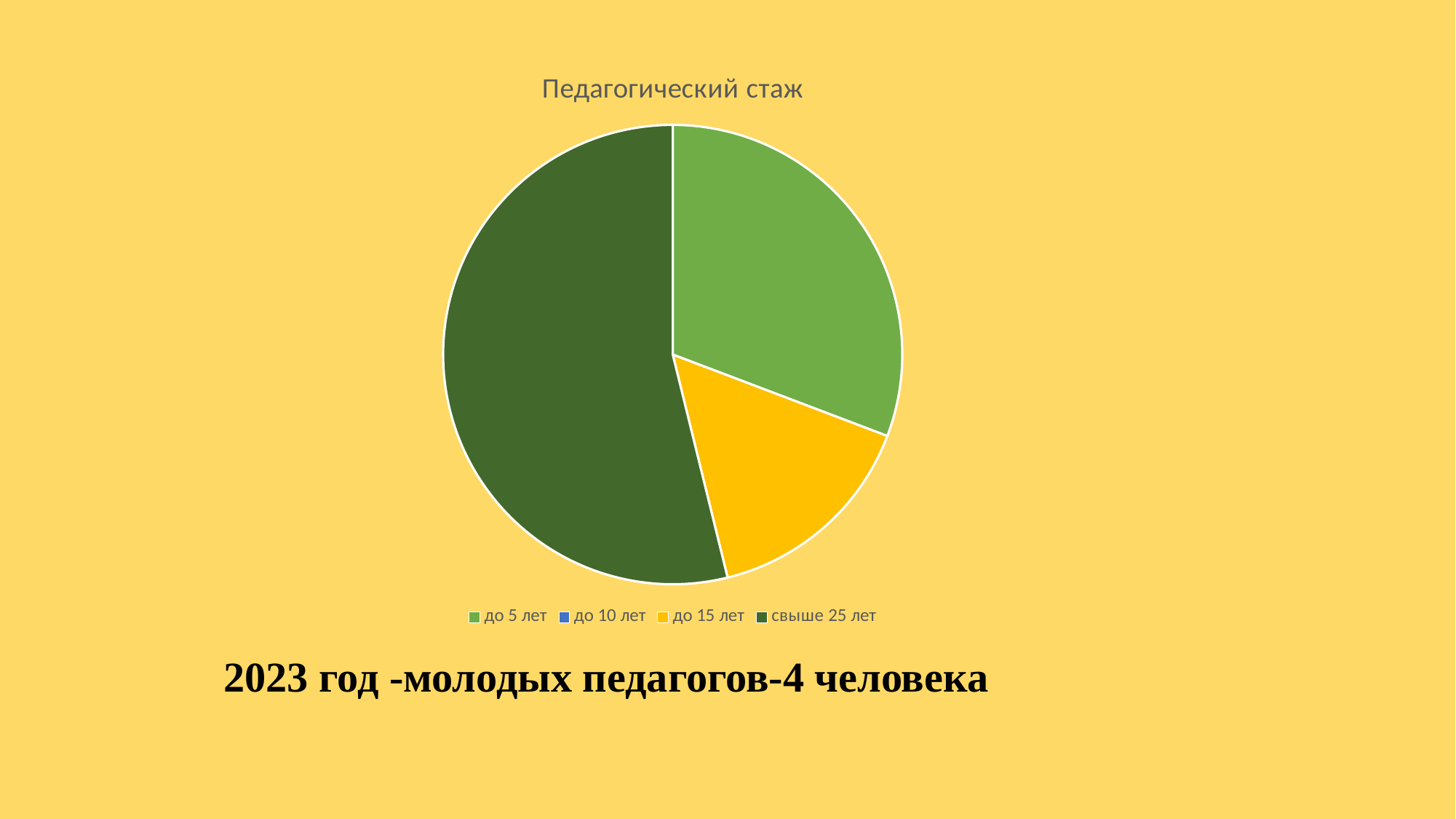
What kind of chart is shown on the slide? Pie chart Which slice is larger, свыше 25 лет or до 5 лет? свыше 25 лет Which slice is larger, до 15 лет or свыше 25 лет? свыше 25 лет Which legend category has no visible slice in the pie? до 10 лет Which slice is larger, до 5 лет or до 15 лет? до 5 лет Which category has the largest slice of the pie? свыше 25 лет How many categories does the chart legend list? 4 Does the свыше 25 лет slice take up more or less than half of the pie? more What is the title of the chart? Педагогический стаж